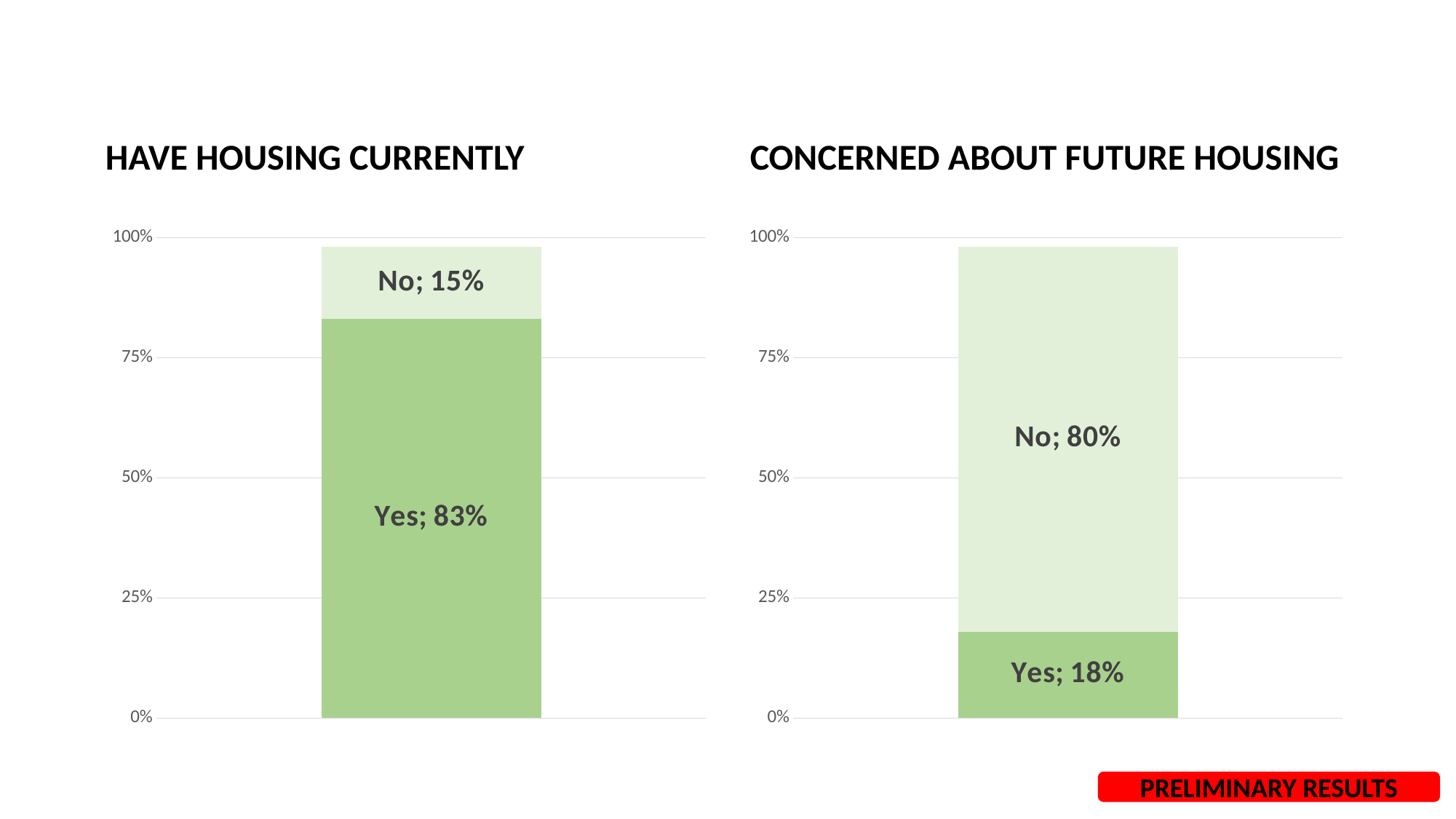
In the 'Concerned about future housing' chart, what percentage answered No? 80% In the 'Have housing currently' chart, what is the total of the Yes and No segments? 98% In the 'Have housing currently' chart, which response has the larger share, Yes or No? Yes In the 'Concerned about future housing' chart, what percentage answered Yes? 18% In the 'Concerned about future housing' chart, what is the difference between the No and Yes percentages? 62% What kind of chart is used on the left side of the slide? Stacked bar chart In the 'Concerned about future housing' chart, is the Yes value greater or less than 25%? less In the 'Have housing currently' chart, what percentage answered No? 15% What is the title of the chart on the right side of the slide? Concerned about future housing In the 'Have housing currently' chart, what is the difference between the Yes and No percentages? 68% In the 'Have housing currently' chart, what percentage answered Yes? 83% In the 'Concerned about future housing' chart, which response has the smaller share? Yes